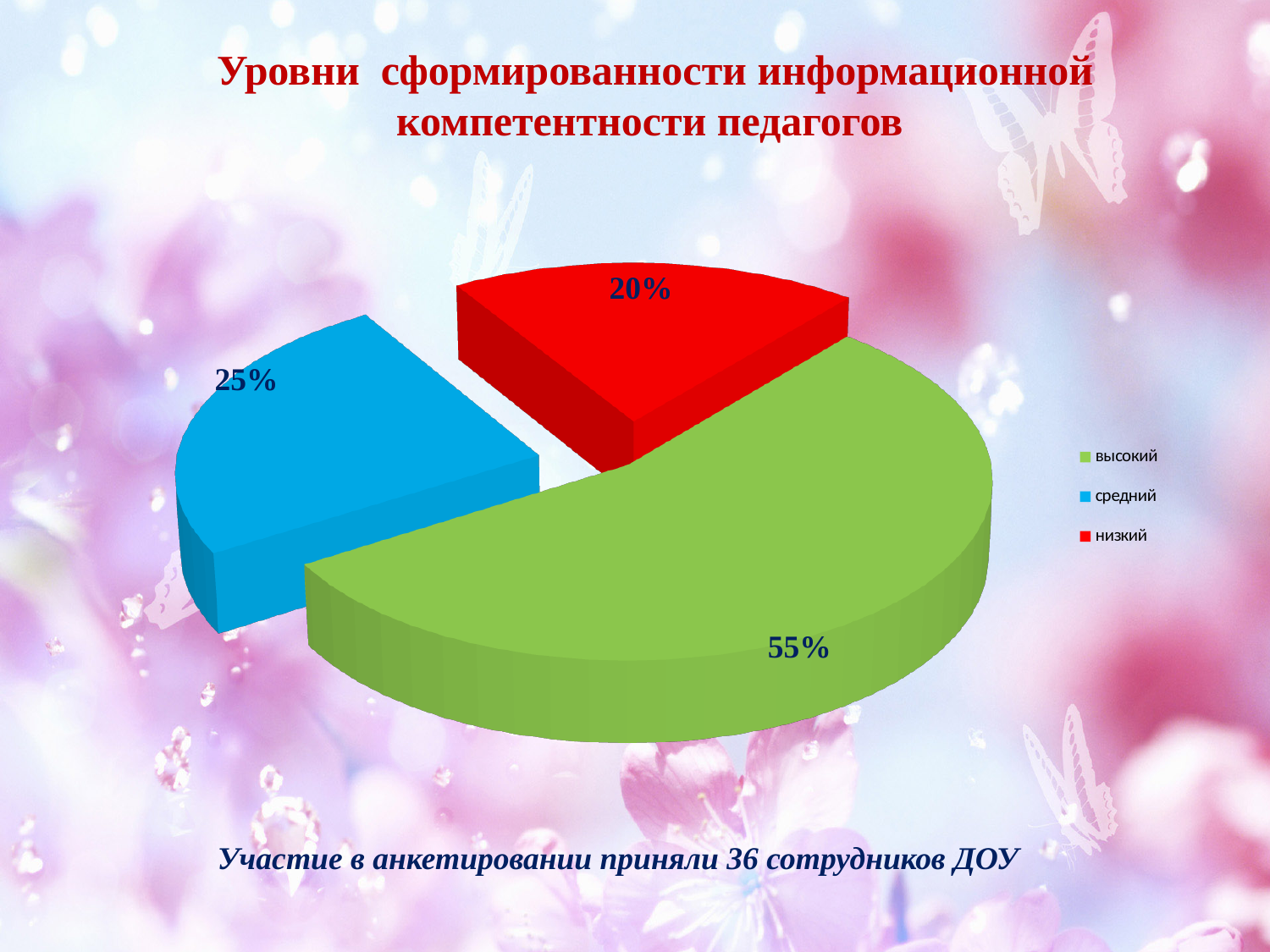
How many slices does the pie chart have? 3 How many entries does the legend list? 3 Which category has the smallest slice of the pie? низкий What is the difference in percentage points between the 'средний' and 'низкий' slices? 5 What share of the pie does the 'низкий' slice represent? 20% Which category has the largest slice of the pie? высокий What is the difference in percentage points between the 'высокий' and 'средний' slices? 30 What share of the pie does the 'высокий' slice represent? 55% What colour is the 'низкий' slice? red Which is larger, the 'средний' slice or the 'низкий' slice? средний What kind of chart is shown on the slide? pie chart What share of the pie does the 'средний' slice represent? 25%